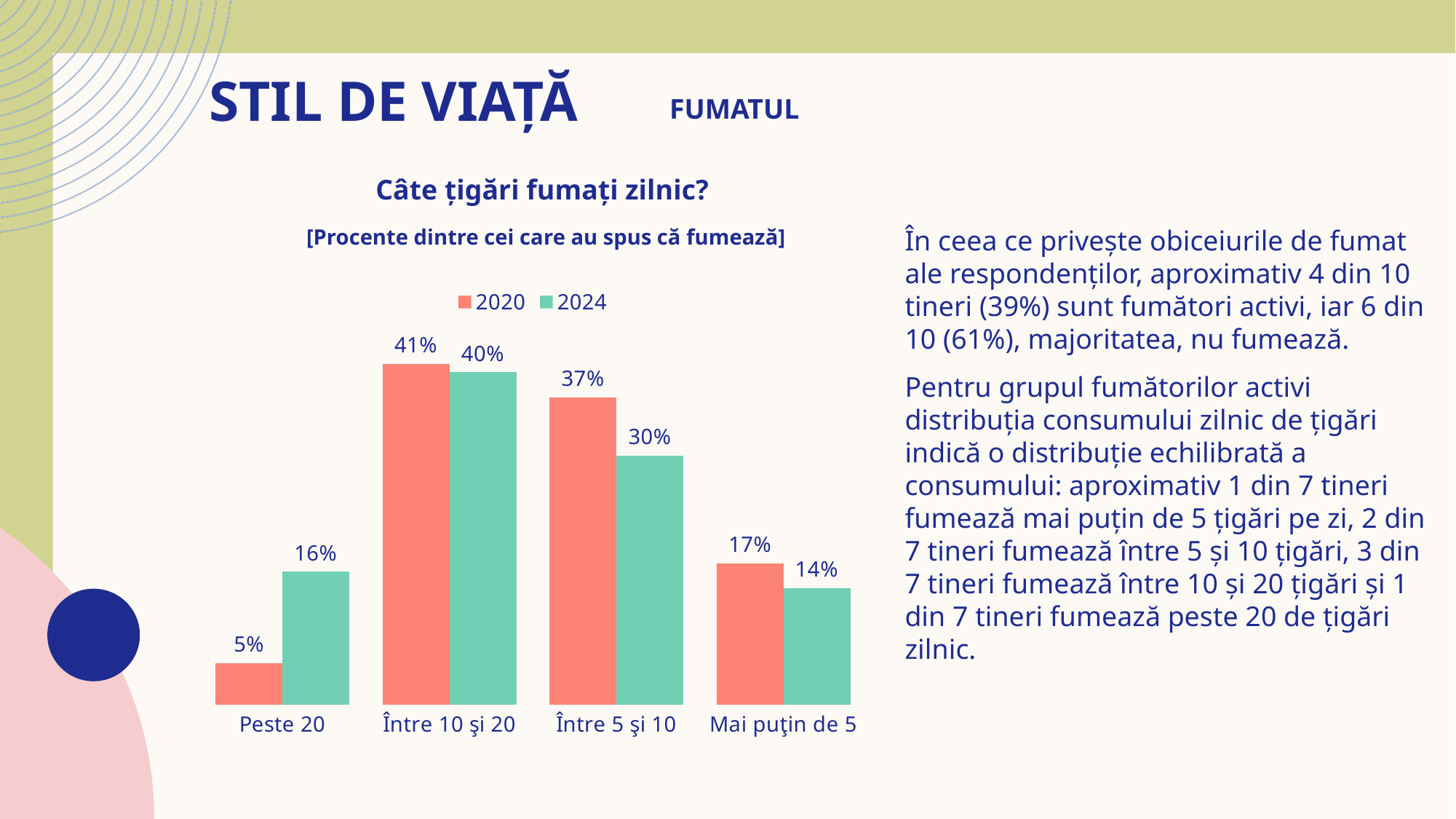
What is the difference between the 2024 and 2020 values for "Peste 20"? 11% How many categories are shown on the x axis? 4 Which category has the highest 2020 value? Între 10 şi 20 What is the difference between the 2020 and 2024 values for "Între 5 şi 10"? 7% How many series does the legend list? 2 What is the title of the chart? Câte ţigări fumaţi zilnic? Which is larger for "Mai puţin de 5": the 2020 value or the 2024 value? 2020 What is the 2024 value for "Mai puţin de 5"? 14% What is the 2020 value for "Peste 20"? 5% Which category has the lowest 2024 value? Mai puţin de 5 What is the 2024 value for "Între 5 şi 10"? 30% What kind of chart is shown on the slide? Bar chart